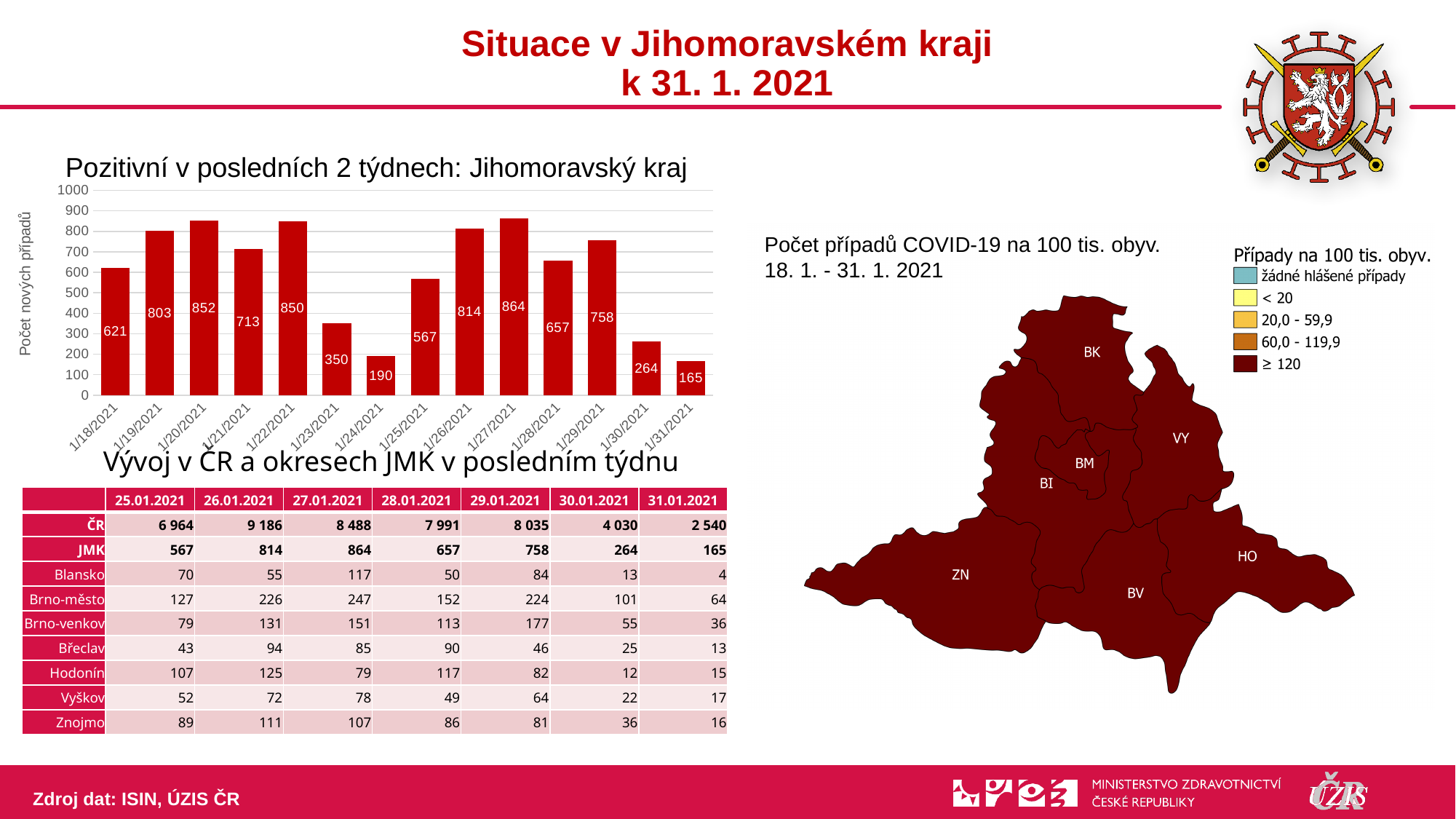
Is the value for 1/23/2021 greater or less than 400? less Which date has the highest value? 1/27/2021 What type of chart is shown on the slide? bar chart Which date has the lowest value? 1/31/2021 What is the title of the chart? Pozitivní v posledních 2 týdnech: Jihomoravský kraj What is the value for 1/27/2021? 864 Which is larger, the value for 1/19/2021 or the value for 1/21/2021? 1/19/2021 Do the values rise or fall from 1/27/2021 to 1/31/2021? fall overall (864, 657, 758, 264, 165), with a rise on 1/29/2021 How many dates (bars) are shown in the chart? 14 What is the value for 1/24/2021? 190 What is the difference between the values for 1/18/2021 and 1/31/2021? 456 What is the value for 1/18/2021? 621